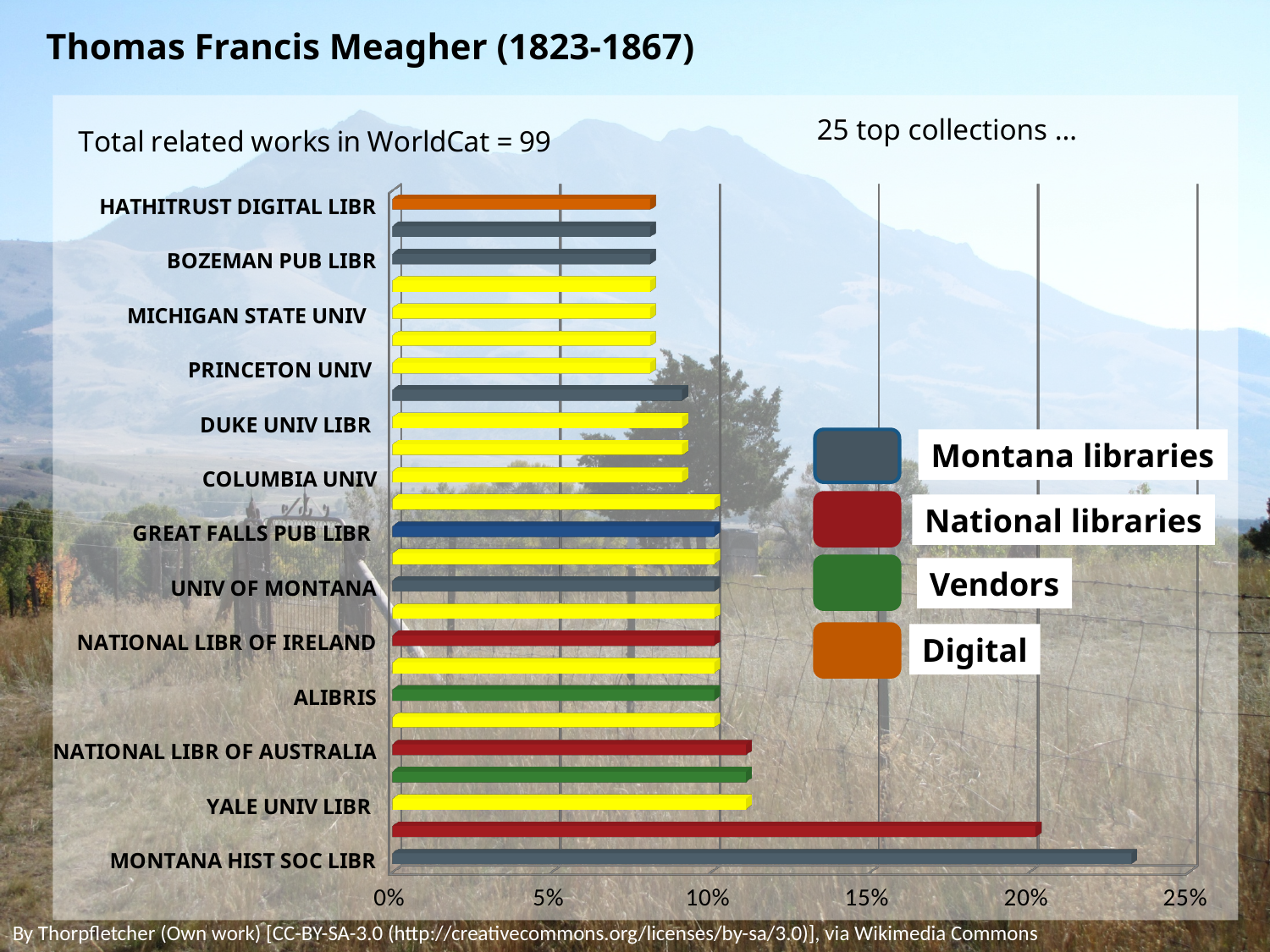
How many categories does the chart legend list? 4 Which collection has the highest value in the chart? MONTANA HIST SOC LIBR Which has a larger value, NATIONAL LIBR OF AUSTRALIA or HATHITRUST DIGITAL LIBR? NATIONAL LIBR OF AUSTRALIA Which has a larger value, MONTANA HIST SOC LIBR or YALE UNIV LIBR? MONTANA HIST SOC LIBR Is the value for MONTANA HIST SOC LIBR greater or less than 20%? greater How many bars are plotted in the chart? 25 Is the value for YALE UNIV LIBR greater or less than 15%? less Is the value for NATIONAL LIBR OF AUSTRALIA greater or less than 10%? greater What kind of chart is shown on the slide? bar chart According to the legend, which category do the green bars represent? Vendors